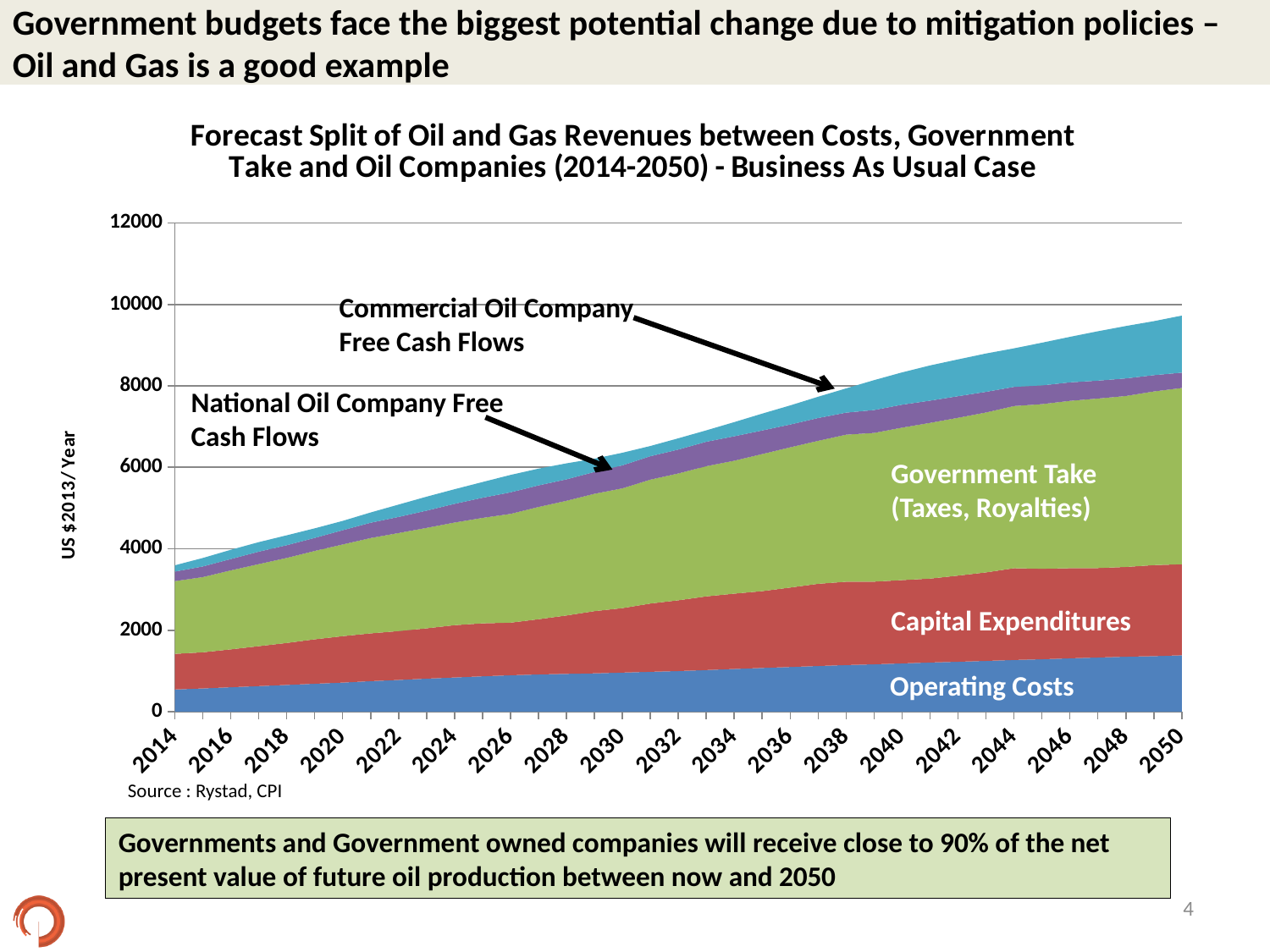
Is the total stacked value in 2014 greater or less than 4000? less What kind of chart is shown on the slide? Stacked area chart Which band is the thinnest across the forecast period? National Oil Company Free Cash Flows What source is cited for the chart? Rystad, CPI How many revenue components are labelled on the chart? 5 Is the total stacked value in 2050 greater or less than 8000? greater Is the top of the Operating Costs band in 2050 greater or less than 2000? less What is the label on the vertical axis? US $2013/ Year Does the total of all bands rise or fall from 2014 to 2050? Rise Which band takes the largest share of revenues across the forecast period? Government Take (Taxes, Royalties)